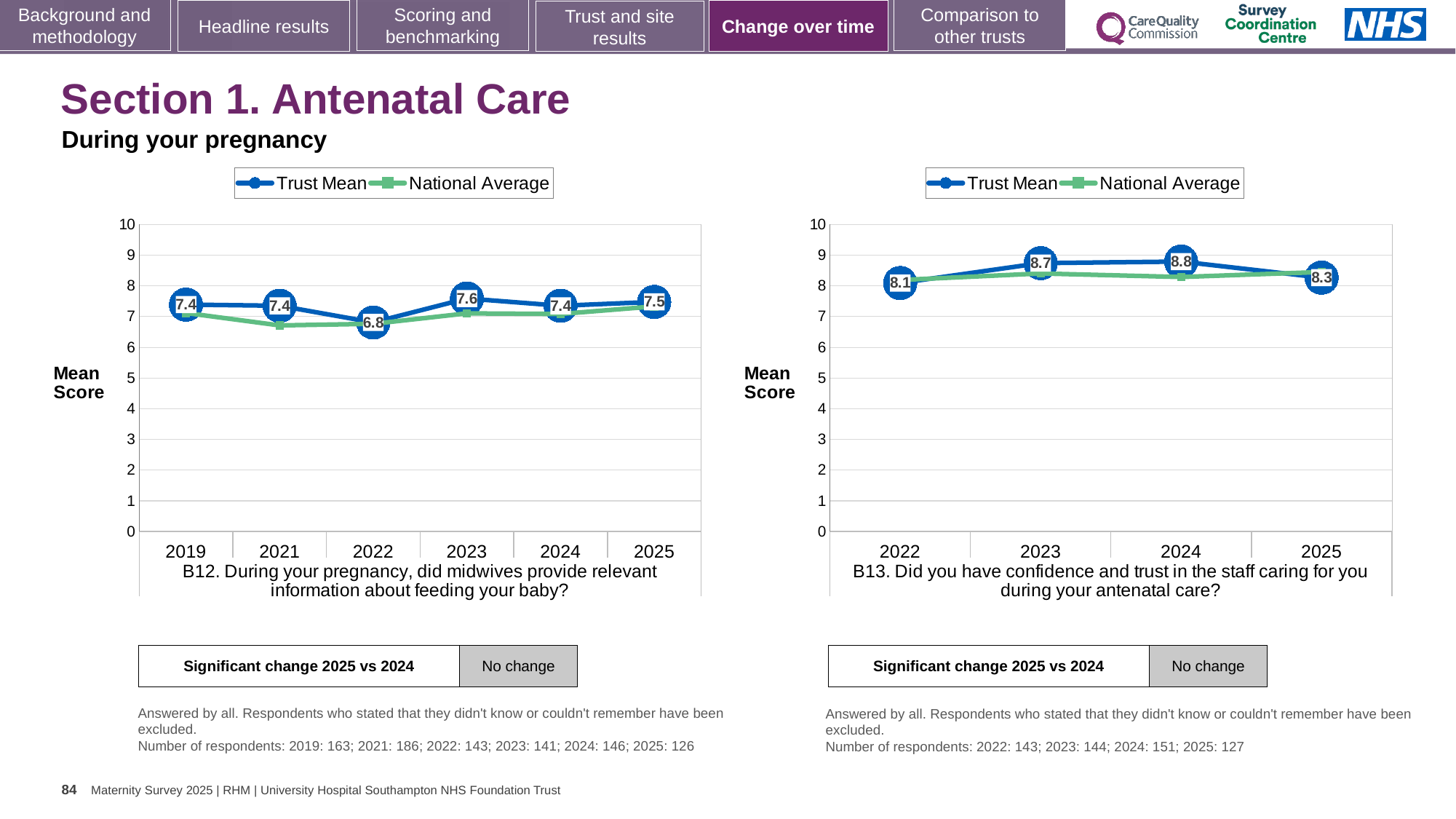
How many years are plotted on the x axis of the B13 chart (right)? 4 In the B12 chart (left), is the National Average for 2021 greater or less than 7? less In the B12 chart (left), is the Trust Mean for 2023 or for 2022 larger? 2023 In the B12 chart (left), what is the Trust Mean for 2023? 7.6 In the B13 chart (right), what is the Trust Mean for 2024? 8.8 What kind of chart is the B13 chart (right)? Line chart In the B12 chart (left), what is the Trust Mean for 2022? 6.8 How many series does the legend of the B12 chart (left) list? 2 In the B12 chart (left), which year has the lowest Trust Mean? 2022 In the B13 chart (right), which year has the highest Trust Mean? 2024 In the B13 chart (right), what is the Trust Mean for 2022? 8.1 In the B13 chart (right), what is the difference between the Trust Mean for 2024 and the Trust Mean for 2025? 0.5